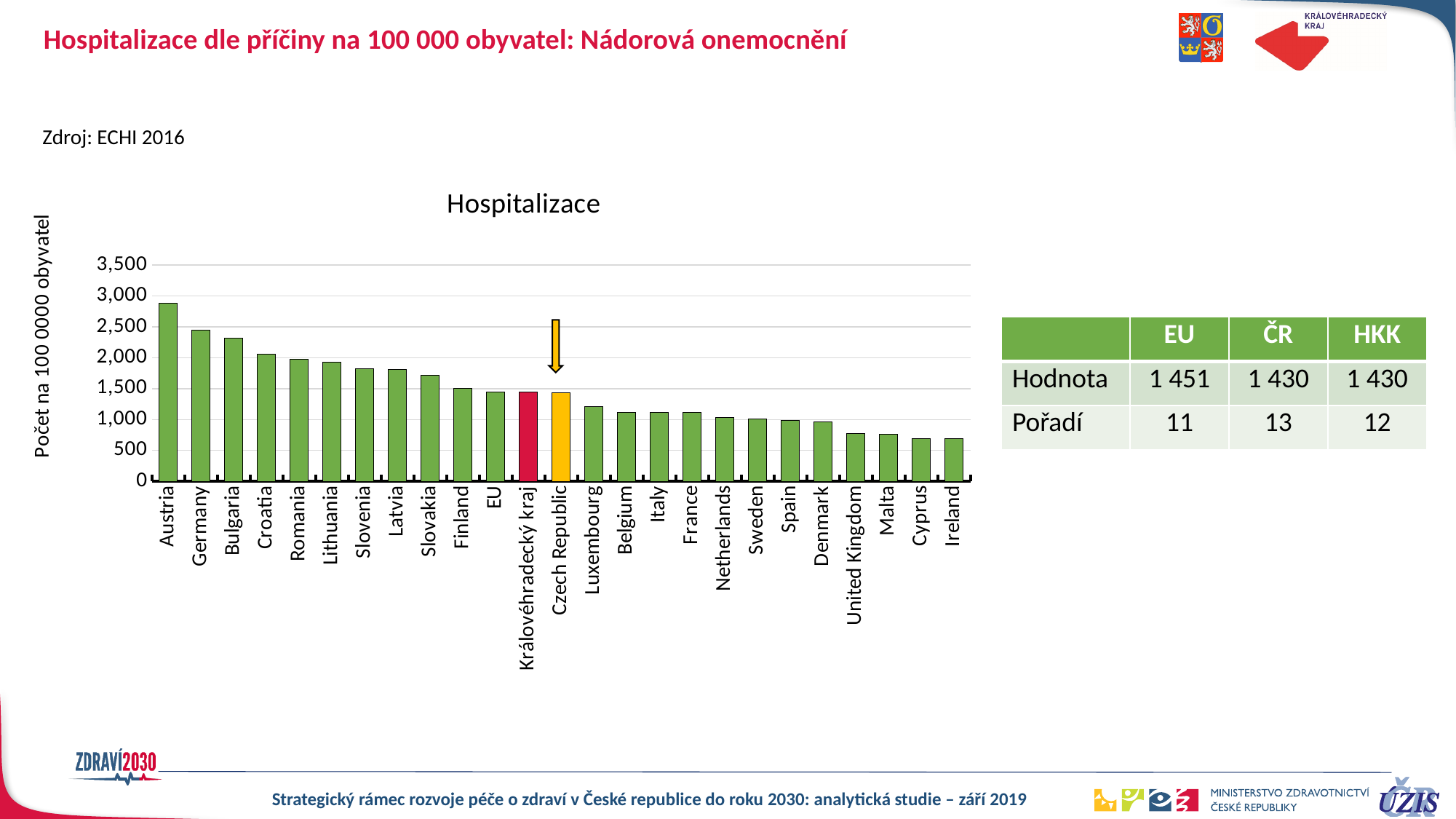
Which category has the highest value in the chart? Austria What is the value for EU according to the table on the slide? 1 451 Is the value for Luxembourg greater or less than 1,000? greater What is the difference between the EU value and the ČR value shown in the table? 21 What is the value for Czech Republic (ČR) according to the table on the slide? 1 430 What type of chart is shown on the slide? Bar chart Is the value for Austria greater or less than 2,500? greater What is the title of the chart? Hospitalizace Is the value for Slovakia greater or less than 1,500? greater How many bars (categories) are plotted in the chart? 25 Do the values rise or fall moving from left to right along the x axis? Fall Which has a larger value, Bulgaria or Croatia? Bulgaria